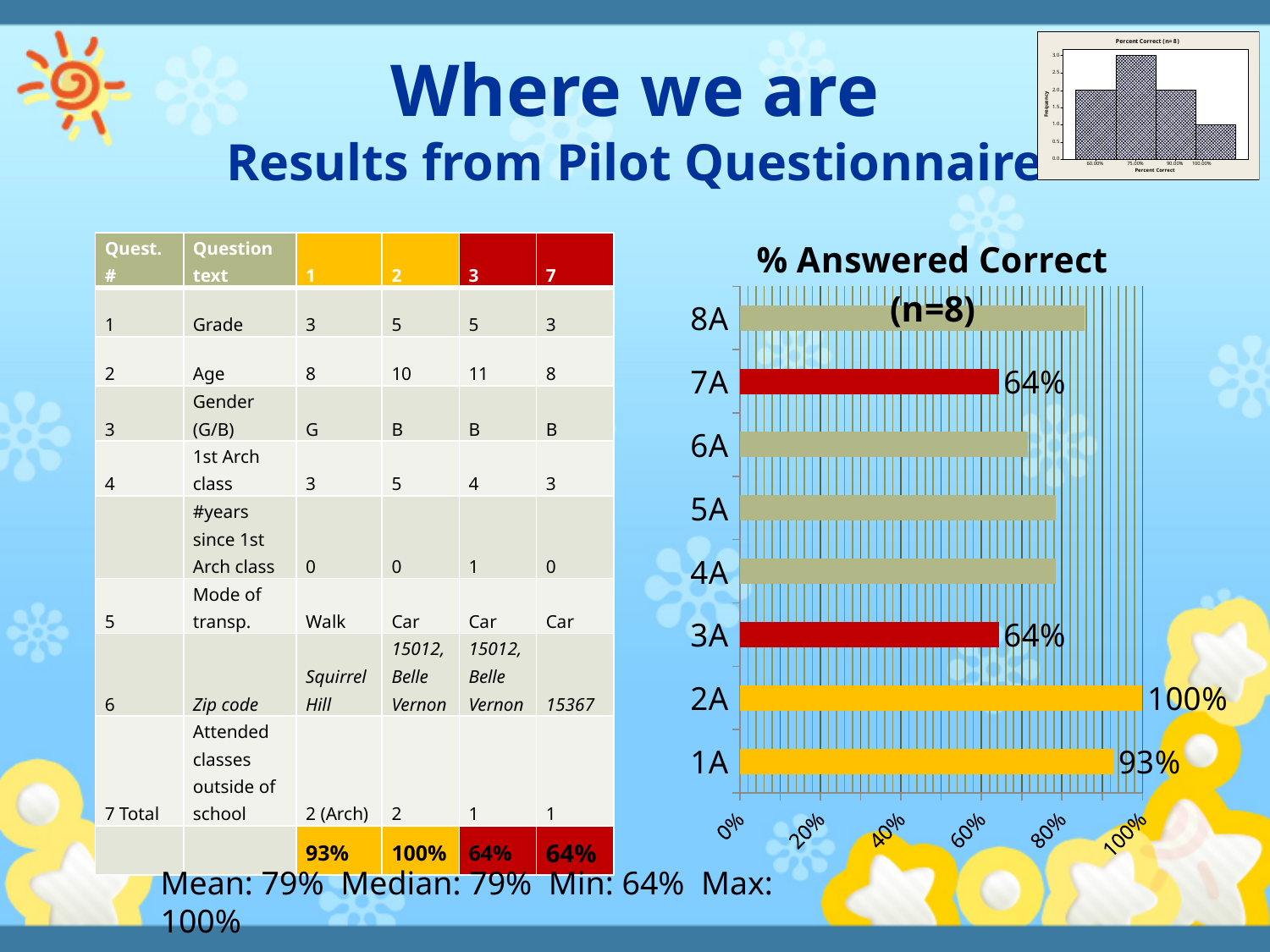
In the '% Answered Correct (n=8)' chart, is the value for 6A greater or less than 80%? less In the '% Answered Correct (n=8)' chart, what is the value for 3A? 64% In the '% Answered Correct (n=8)' chart, what is the difference between the values for 2A and 1A? 7% In the '% Answered Correct (n=8)' chart, what is the value for 7A? 64% In the '% Answered Correct (n=8)' chart, what is the value for 1A? 93% What kind of chart is the '% Answered Correct (n=8)' chart? bar chart In the '% Answered Correct (n=8)' chart, what is the difference between the values for 1A and 3A? 29% In the '% Answered Correct (n=8)' chart, is the value for 8A greater or less than 80%? greater In the '% Answered Correct (n=8)' chart, what is the value for 2A? 100% How many categories are shown in the '% Answered Correct (n=8)' chart? 8 In the '% Answered Correct (n=8)' chart, which category has the highest value? 2A In the '% Answered Correct (n=8)' chart, which is larger, the value for 1A or the value for 7A? 1A